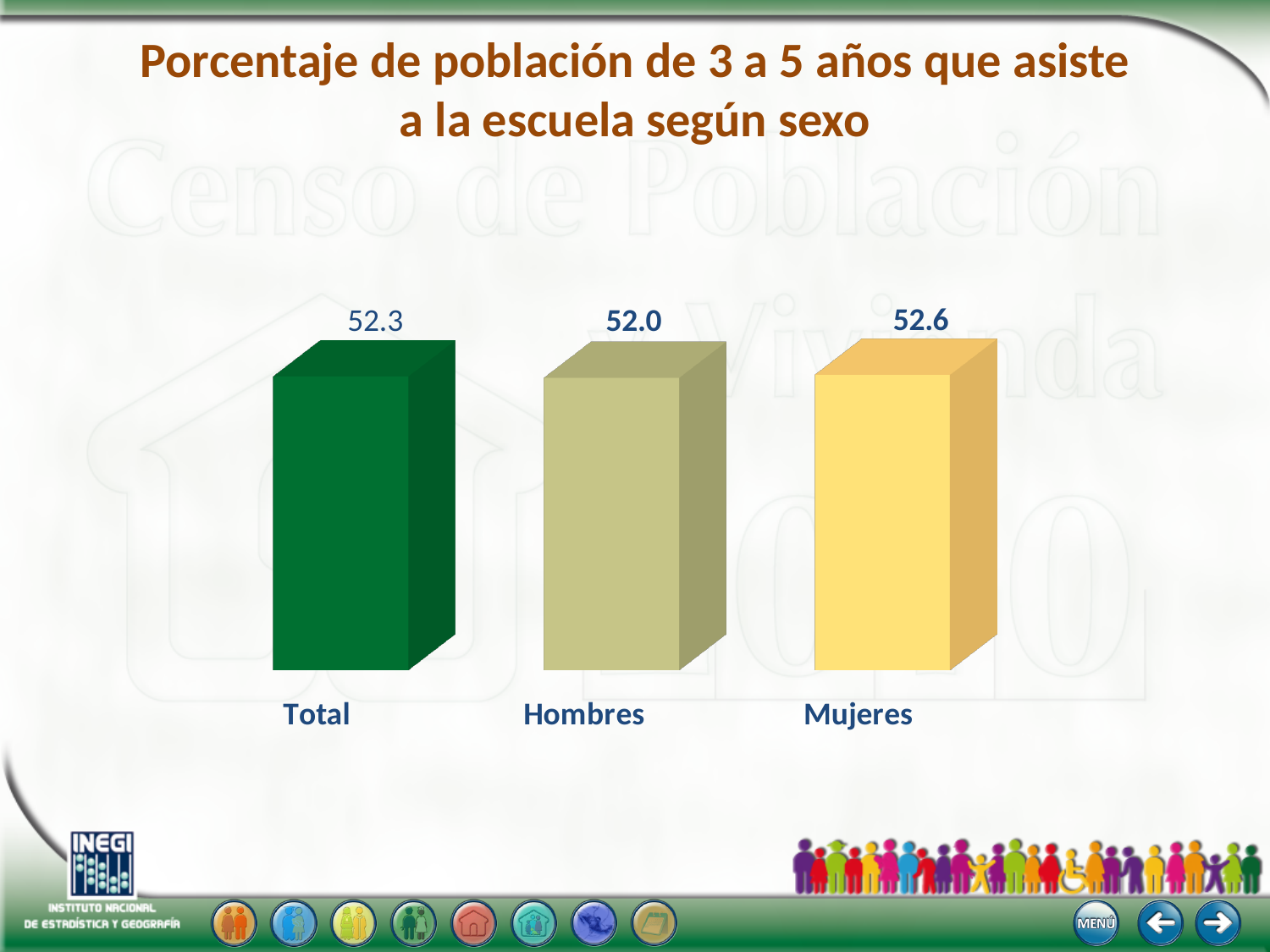
What kind of chart is shown on the slide? bar chart What colour is the bar for Total? dark green What is the value for Hombres? 52.0 What is the difference between the values for Mujeres and Total? 0.3 Which category has the highest value? Mujeres Which category has the lowest value? Hombres How many categories are shown in the chart? 3 Which is larger, the value for Hombres or the value for Mujeres? Mujeres What is the title of the chart? Porcentaje de población de 3 a 5 años que asiste a la escuela según sexo What is the value for Total? 52.3 What is the value for Mujeres? 52.6 What is the difference between the values for Mujeres and Hombres? 0.6